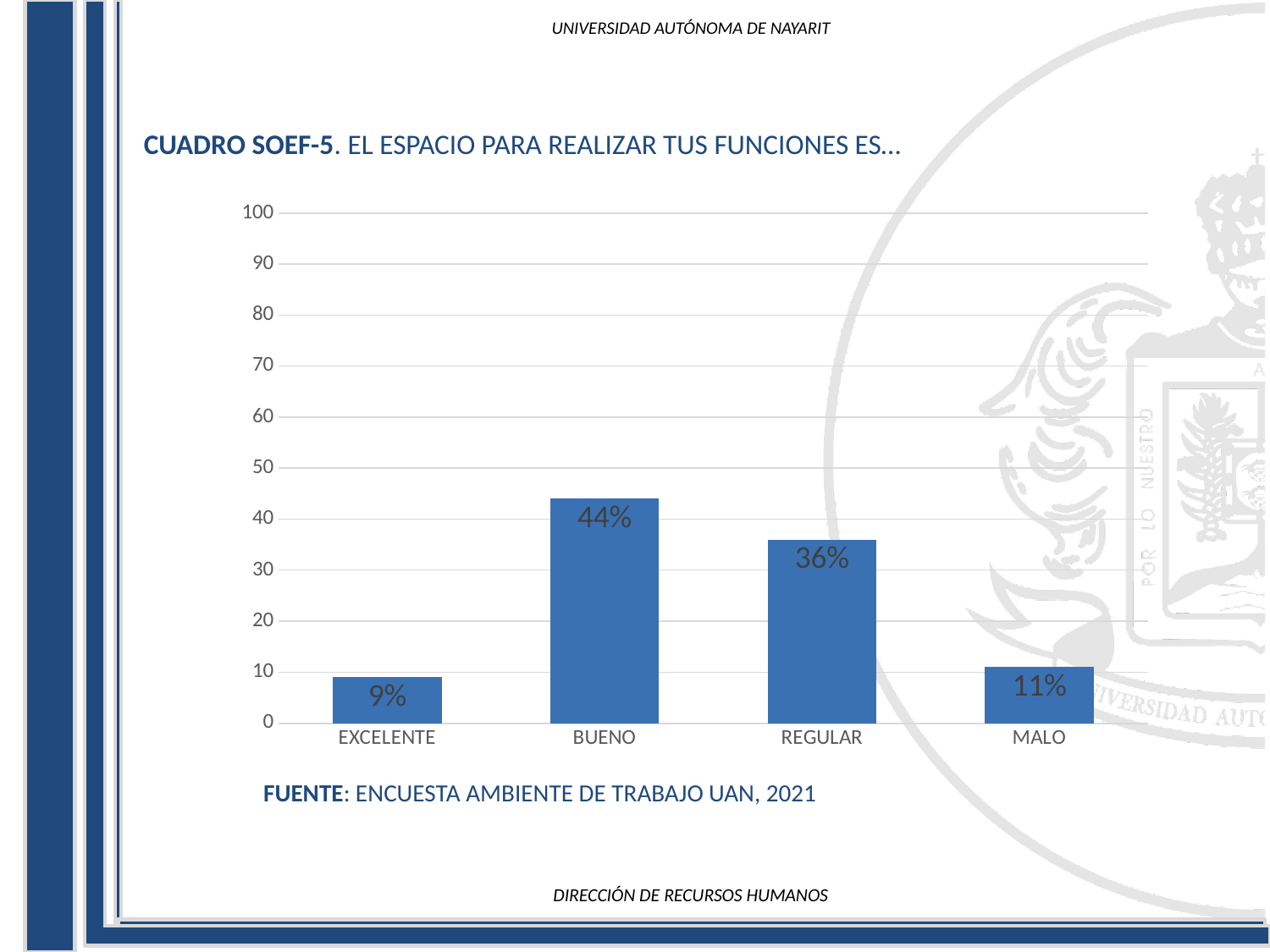
How many categories are shown on the x axis? 4 What kind of chart is shown on the slide? bar chart What is the value for EXCELENTE? 9% What is the value for BUENO? 44% Which category has the highest value? BUENO What is the value for MALO? 11% Which category has the lowest value? EXCELENTE What is the value for REGULAR? 36% Which is larger, the value for MALO or the value for EXCELENTE? MALO Is the value for REGULAR greater or less than 30? greater What is the difference between the values for BUENO and REGULAR? 8% What source is cited below the chart? ENCUESTA AMBIENTE DE TRABAJO UAN, 2021